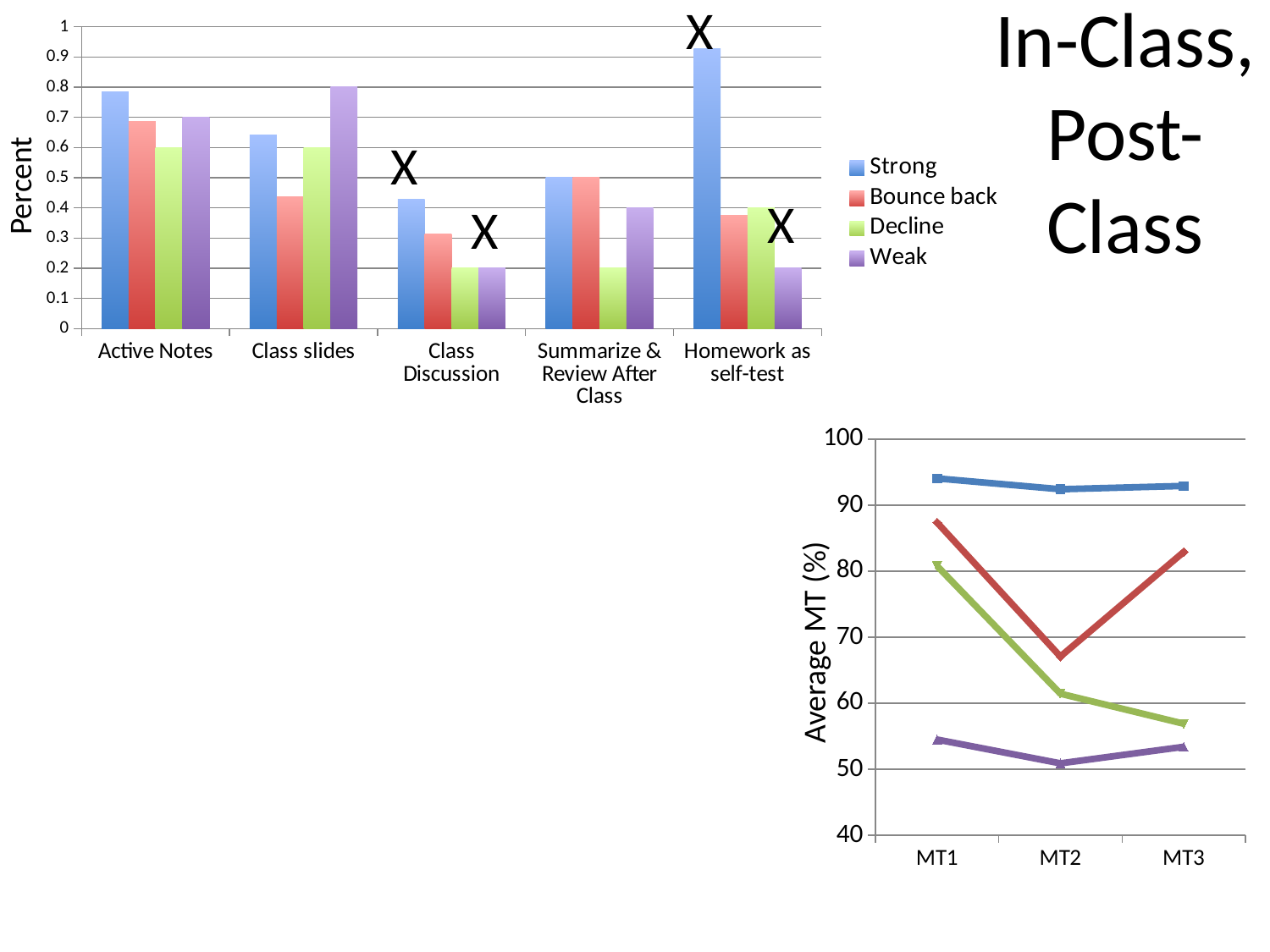
In the top-left bar chart, what is the value for Decline in the Active Notes category? 0.6 What type of chart is the bottom-right chart? line chart How many series does the legend of the top-left bar chart list? 4 In the top-left bar chart, what is the value for Weak in the Class slides category? 0.8 What type of chart is the top-left chart? bar chart In the bottom-right line chart, is the value of the red line at MT2 greater or less than 70? less How many points are on the x axis of the bottom-right line chart? 3 In the top-left bar chart, which is larger for Class slides: Strong or Bounce back? Strong In the top-left bar chart, which series has the highest value in the Homework as self-test category? Strong How many categories are shown on the x axis of the top-left bar chart? 5 In the top-left bar chart, is the value for Strong in the Homework as self-test category greater or less than 0.9? greater In the top-left bar chart, what is the value for Weak in the Summarize & Review After Class category? 0.4